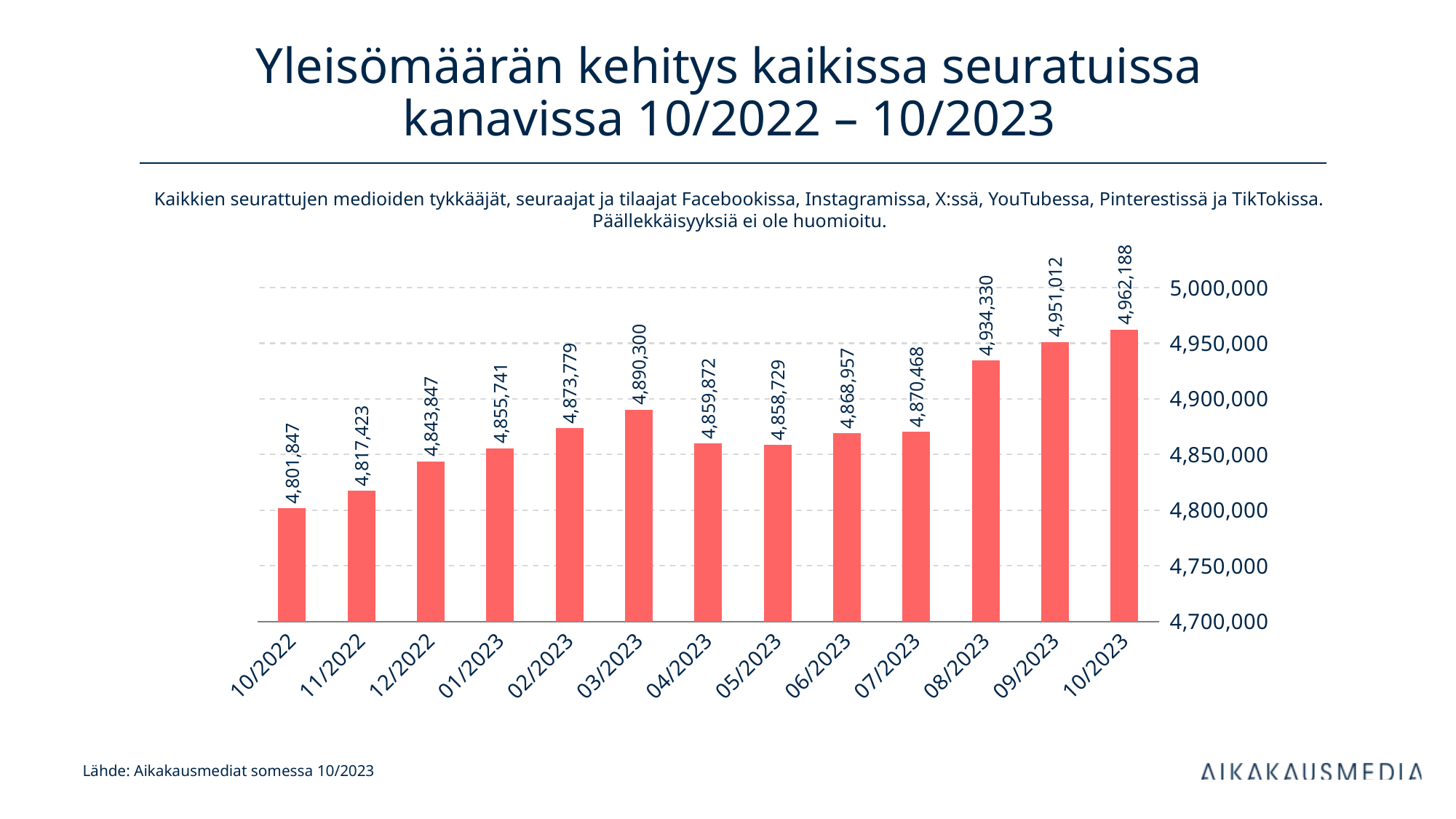
What kind of chart is shown on the slide? bar chart Which month has the highest value? 10/2023 Is the value for 09/2023 greater or less than 4,900,000? greater What is the difference between the values for 10/2023 and 10/2022? 160,341 Which is larger, the value for 03/2023 or the value for 07/2023? 03/2023 What is the value for 10/2022? 4,801,847 What is the value for 08/2023? 4,934,330 Do the values generally rise or fall from 10/2022 to 10/2023? rise Which month has the lowest value? 10/2022 What is the difference between the values for 03/2023 and 04/2023? 30,428 What is the value for 03/2023? 4,890,300 How many months are shown on the x axis? 13